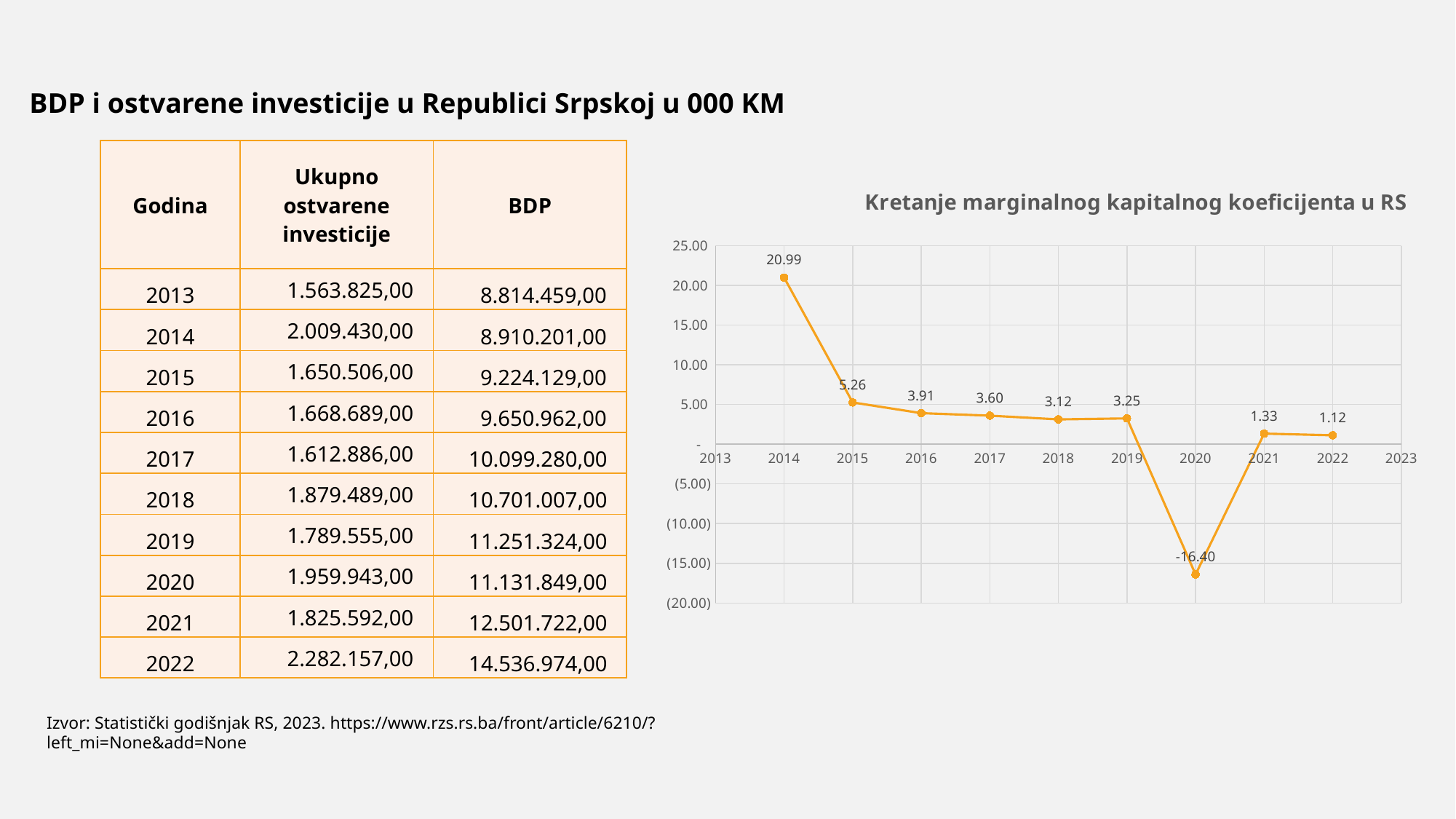
What is the value plotted for 2014 in the chart? 20.99 What is the title of the chart? Kretanje marginalnog kapitalnog koeficijenta u RS Does the value in the chart rise or fall from 2014 to 2015? Fall Which year has the lowest value in the chart? 2020 Which is larger in the chart, the value for 2018 or the value for 2019? 2019 What is the value plotted for 2017 in the chart? 3.60 What is the difference between the values for 2015 and 2016 in the chart? 1.35 What is the value plotted for 2022 in the chart? 1.12 How many data points are plotted in the chart? 9 What is the value plotted for 2020 in the chart? -16.40 Which year has the highest value in the chart? 2014 What type of chart is shown on the slide? Line chart